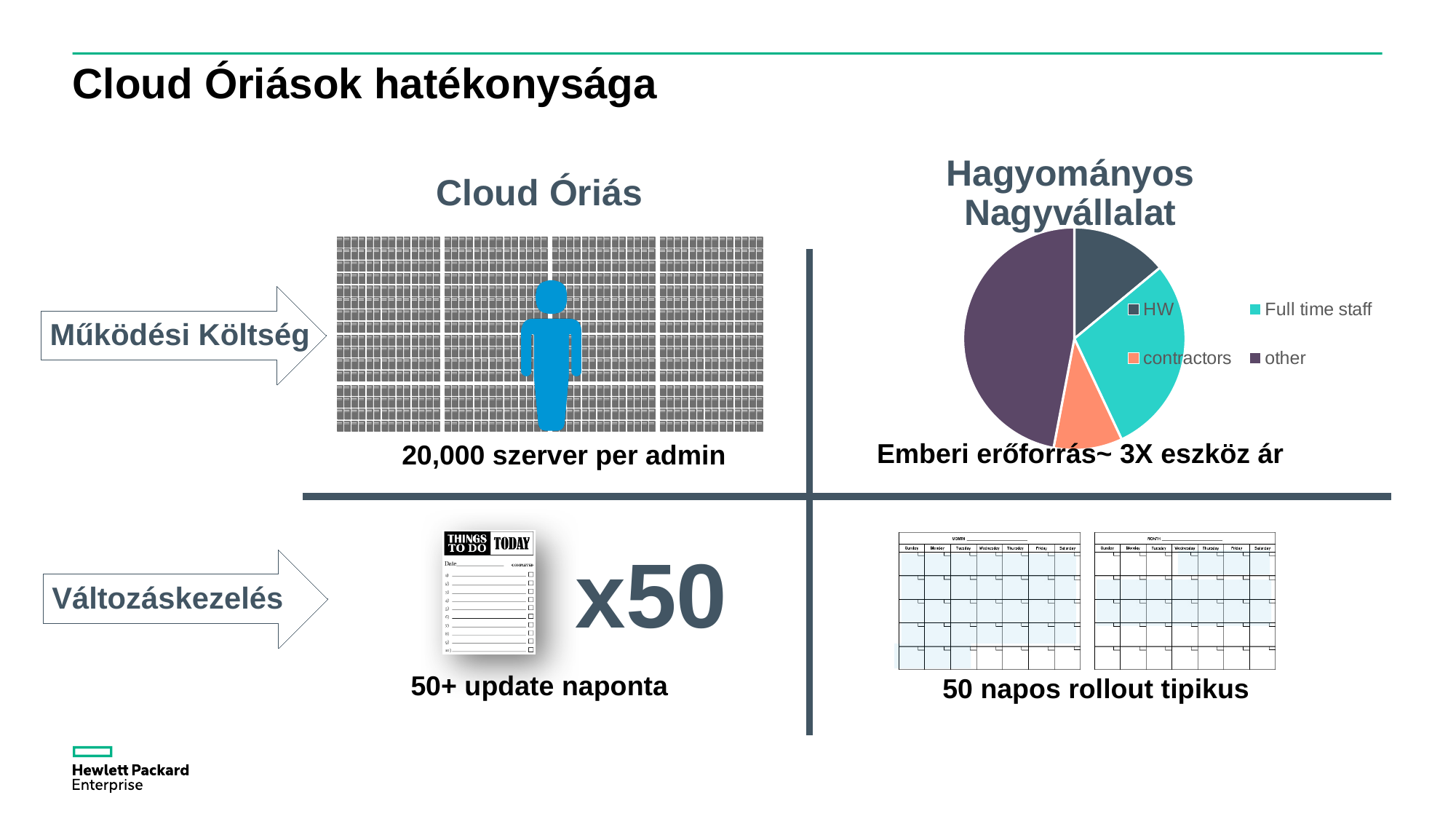
Which category has the smallest slice in the pie chart? contractors What are the four legend entries of the pie chart? HW, Full time staff, contractors, other How many entries does the pie chart's legend list? 4 In the pie chart, which slice is larger: other or Full time staff? other Which category has the largest slice in the pie chart? other What kind of chart is shown on the right side of the slide under "Hagyományos Nagyvállalat"? pie chart How many slices does the pie chart have? 4 In the pie chart, which slice is larger: other or contractors? other What colour is the "contractors" slice in the pie chart? orange In the pie chart, which slice is larger: Full time staff or HW? Full time staff